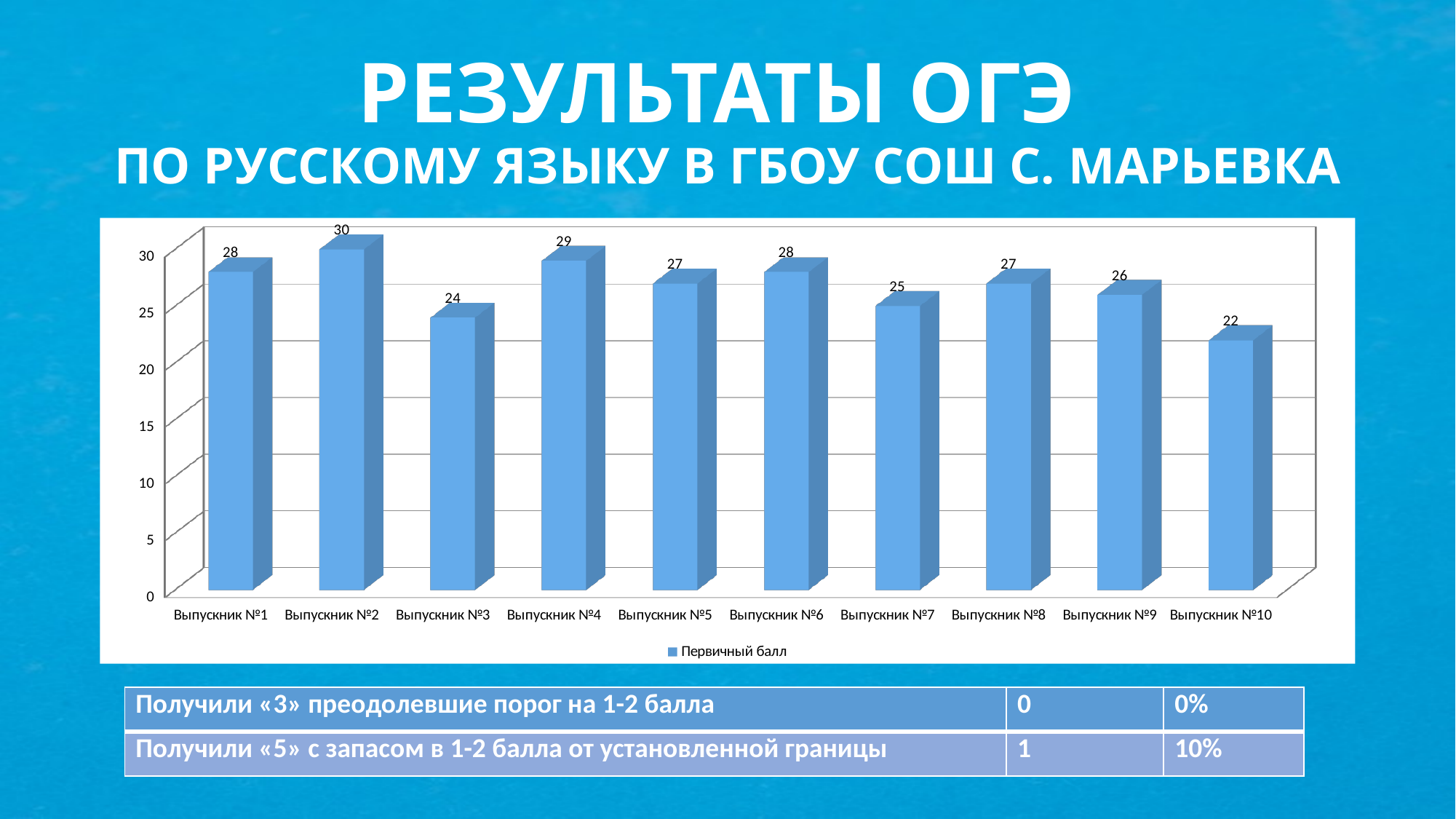
What is the value for Выпускник №10? 22 Which category has the highest value? Выпускник №2 Which category has the lowest value? Выпускник №10 Is the value for Выпускник №9 greater or less than 25? greater How many categories are shown on the x axis? 10 What is the value for Выпускник №2? 30 How many series does the legend list? 1 What is the name of the series in the legend? Первичный балл Which is larger, the value for Выпускник №4 or the value for Выпускник №7? Выпускник №4 What is the value for Выпускник №3? 24 What kind of chart is shown on the slide? bar chart What is the difference between the values for Выпускник №2 and Выпускник №10? 8